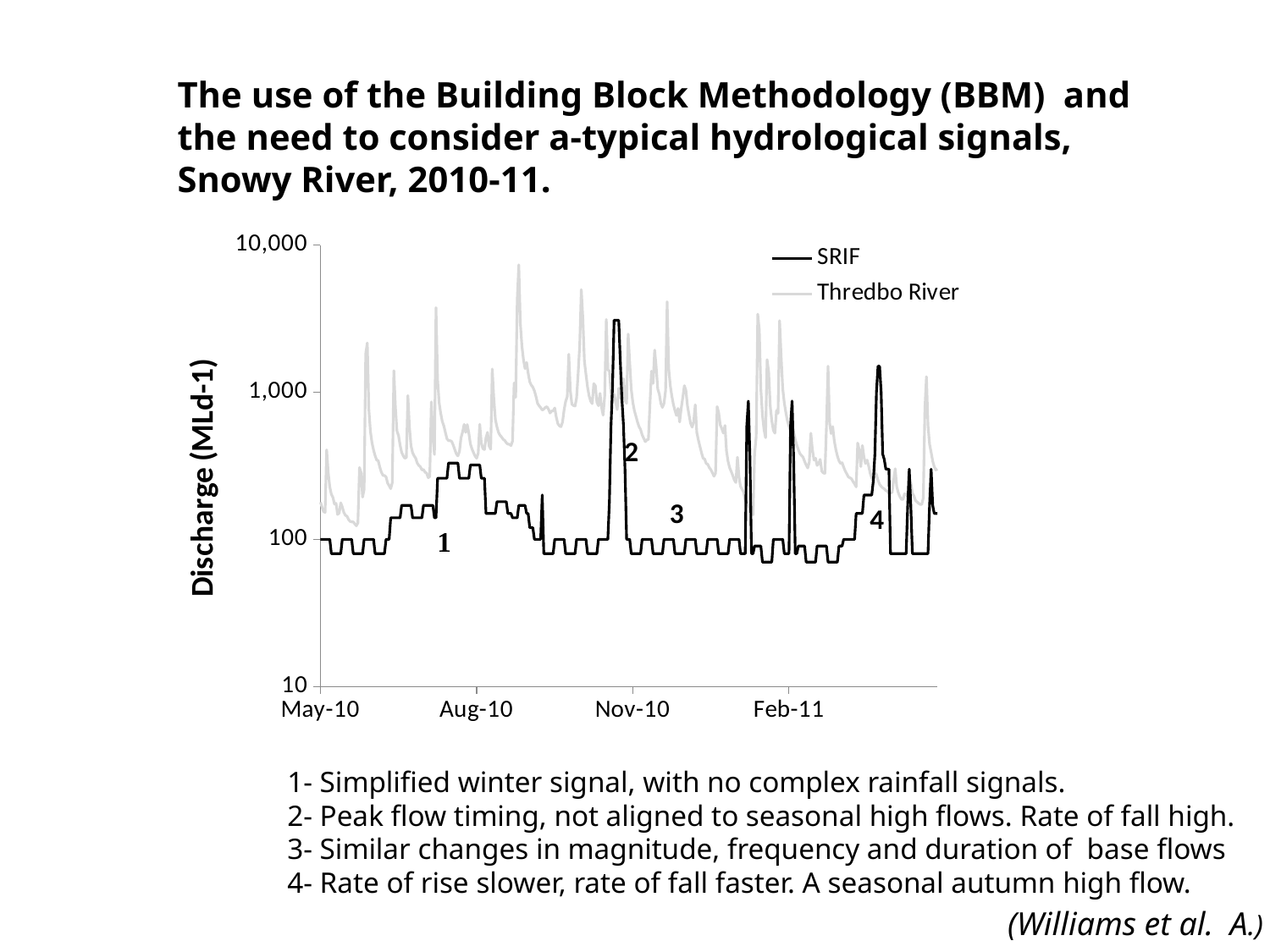
Is the SRIF value at May-10 greater or less than 1,000? less Around Aug-10, which series has the higher discharge, SRIF or Thredbo River? Thredbo River Is the lowest value of the SRIF series greater or less than 10? greater Is the highest peak of the Thredbo River series greater or less than 1,000? greater What kind of chart is shown on the slide? line chart What are the two series named in the chart legend? SRIF and Thredbo River Which series reaches the highest peak discharge on the chart? Thredbo River How many date labels are shown on the x-axis? 4 What is the title of the chart's y-axis? Discharge (MLd-1) How many numbered annotations (1, 2, 3, 4) are marked on the chart? 4 How many series does the chart legend list? 2